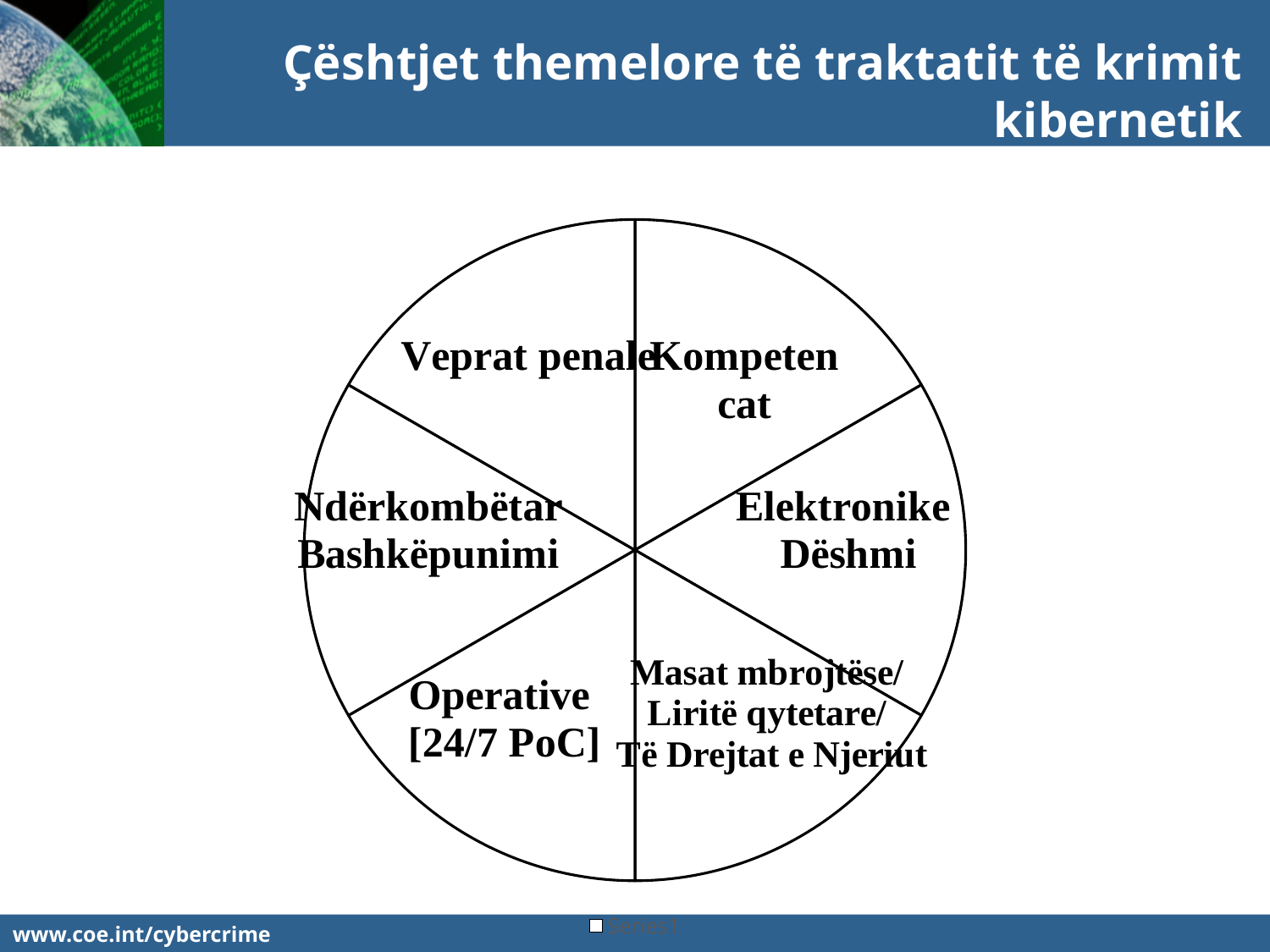
How many series does the legend of the pie chart list? 1 Are the slices of the pie chart roughly equal in size, or does one slice clearly dominate? roughly equal Which slice of the pie chart is labelled with '[24/7 PoC]'? Operative [24/7 PoC] How many slices does the pie chart have? 6 What is the legend entry shown below the pie chart? Series1 What kind of chart is shown on the slide? pie chart